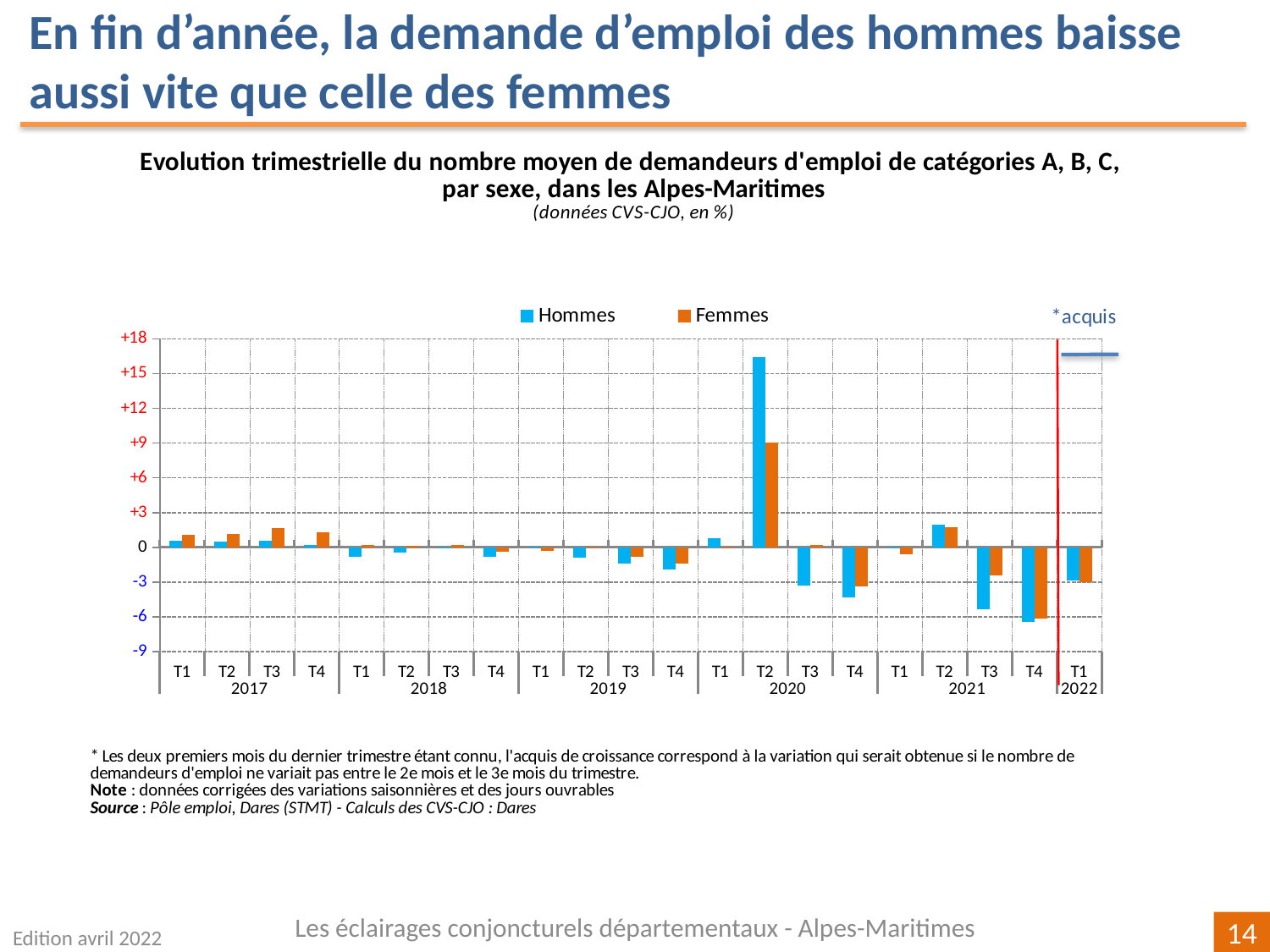
What kind of chart is shown on the slide? bar chart How many quarters are plotted along the x axis? 21 In which quarter is the value for Hommes lowest? T4 2021 Which colour represents the Femmes series in the legend? orange How many series does the legend list? 2 In which quarter is the value for Hommes highest? T2 2020 Is the value for Hommes in T2 2020 greater or less than +15? greater Is the value for Hommes in T3 2021 greater or less than -3? less In which quarter is the value for Femmes lowest? T4 2021 In T2 2020, which series has the larger value, Hommes or Femmes? Hommes In which quarter is the value for Femmes highest? T2 2020 Is the value for Femmes in T2 2020 greater or less than +6? greater